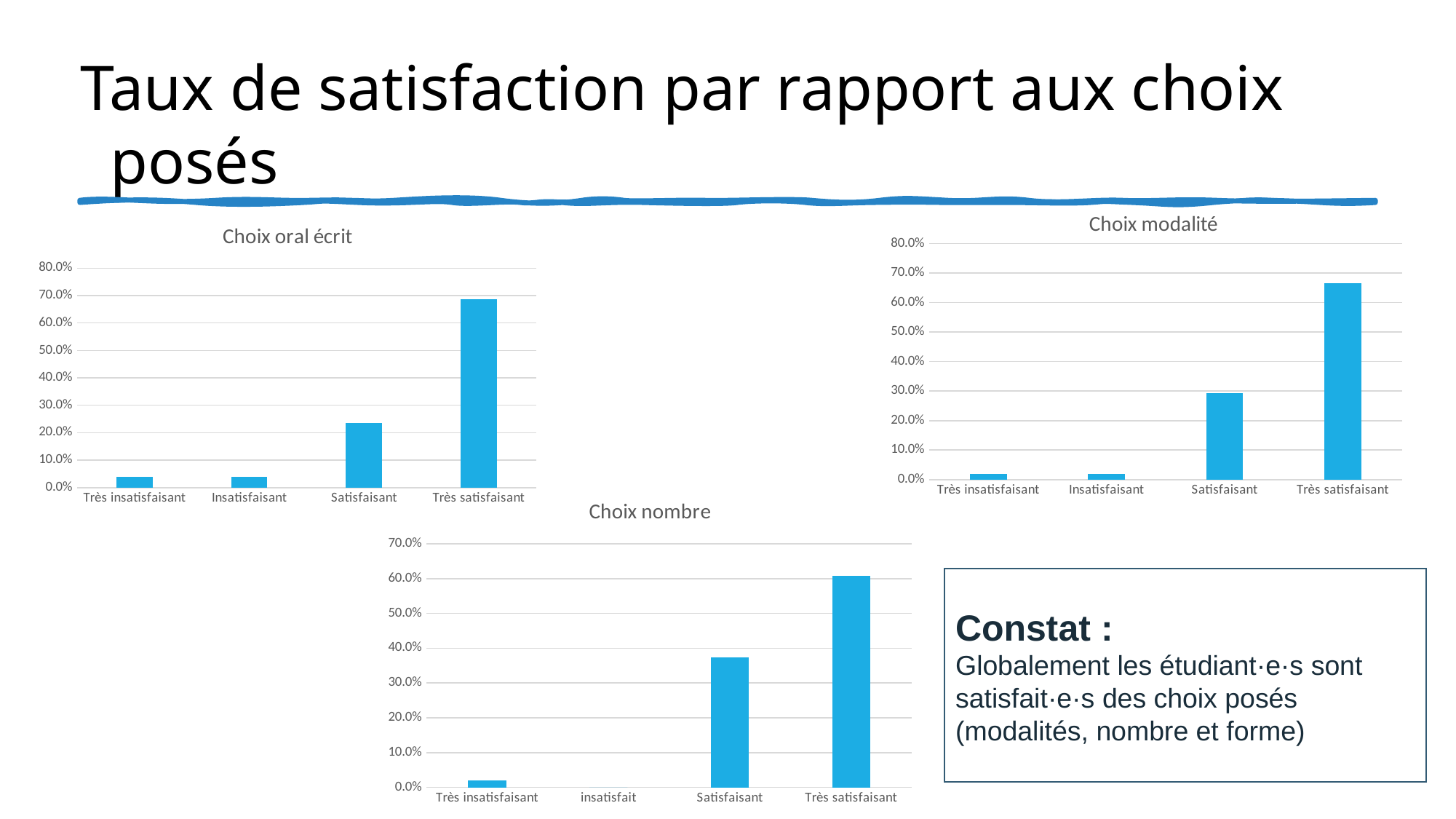
In the 'Choix modalité' chart, which category has the highest value? Très satisfaisant In the 'Choix modalité' chart, is the value for Satisfaisant greater or less than 20.0%? greater In the 'Choix oral écrit' chart, is the value for Très satisfaisant greater or less than 60.0%? greater In the 'Choix modalité' chart, which is larger, Satisfaisant or Très satisfaisant? Très satisfaisant In the 'Choix oral écrit' chart, is the value for Satisfaisant greater or less than 30.0%? less How many charts are shown on the slide? 3 In the 'Choix oral écrit' chart, which category has the highest value? Très satisfaisant What type of chart is 'Choix oral écrit'? bar chart In the 'Choix nombre' chart, which category has the lowest value? insatisfait How many categories are shown in the 'Choix oral écrit' chart? 4